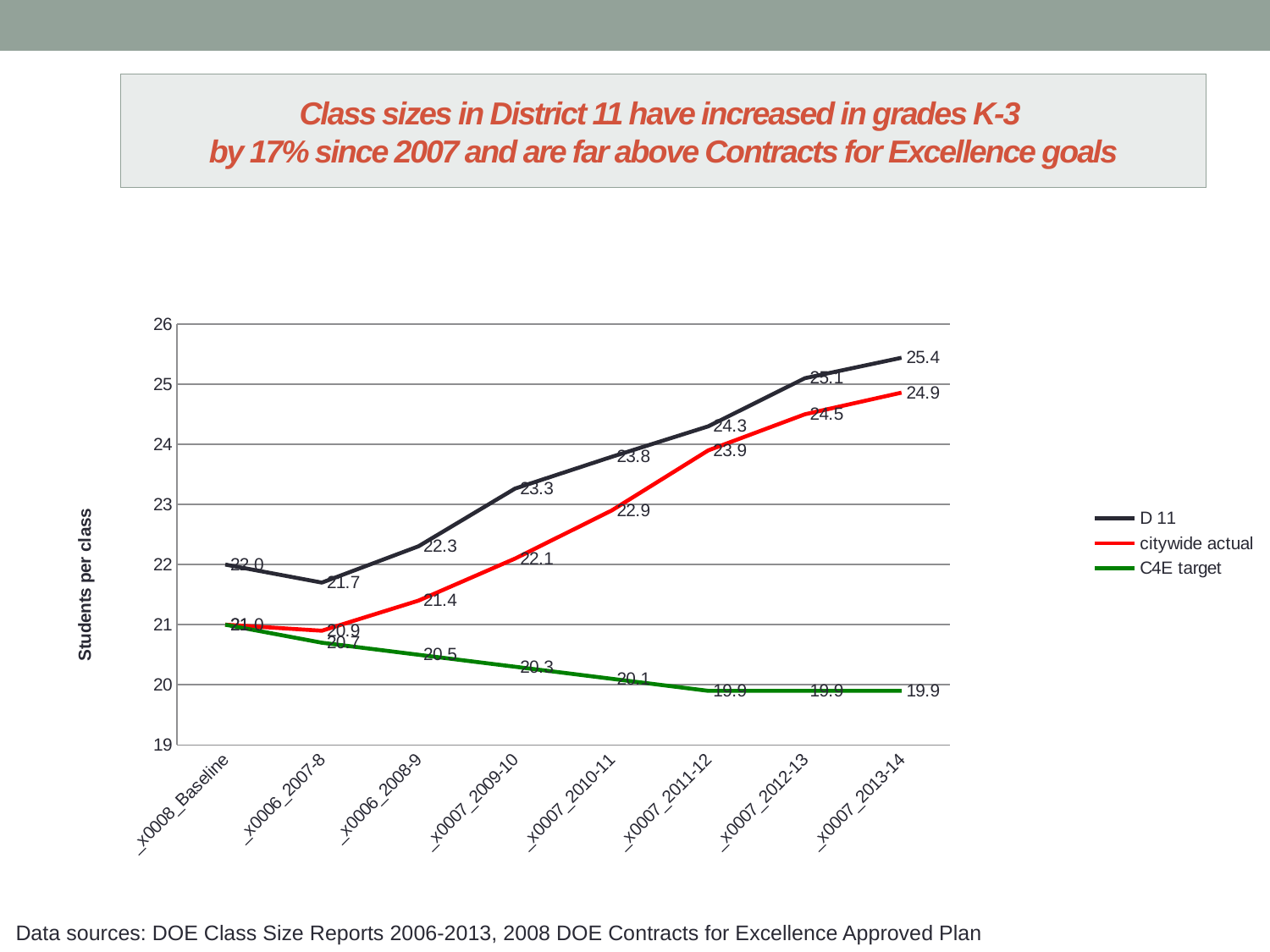
Which is larger in 2011-12, the D 11 value or the citywide actual value? D 11 What is the D 11 value for 2007-8? 21.7 What is the citywide actual value for 2010-11? 22.9 How many series does the legend list? 3 What is the C4E target value for 2013-14? 19.9 What is the label of the y axis? Students per class What kind of chart is shown on the slide? line chart In which period is the D 11 series highest? 2013-14 Does the C4E target series rise or fall from Baseline to 2013-14? fall In which period is the D 11 series lowest? 2007-8 What is the D 11 value for 2013-14? 25.4 What is the difference between the D 11 value and the citywide actual value in 2013-14? 0.5